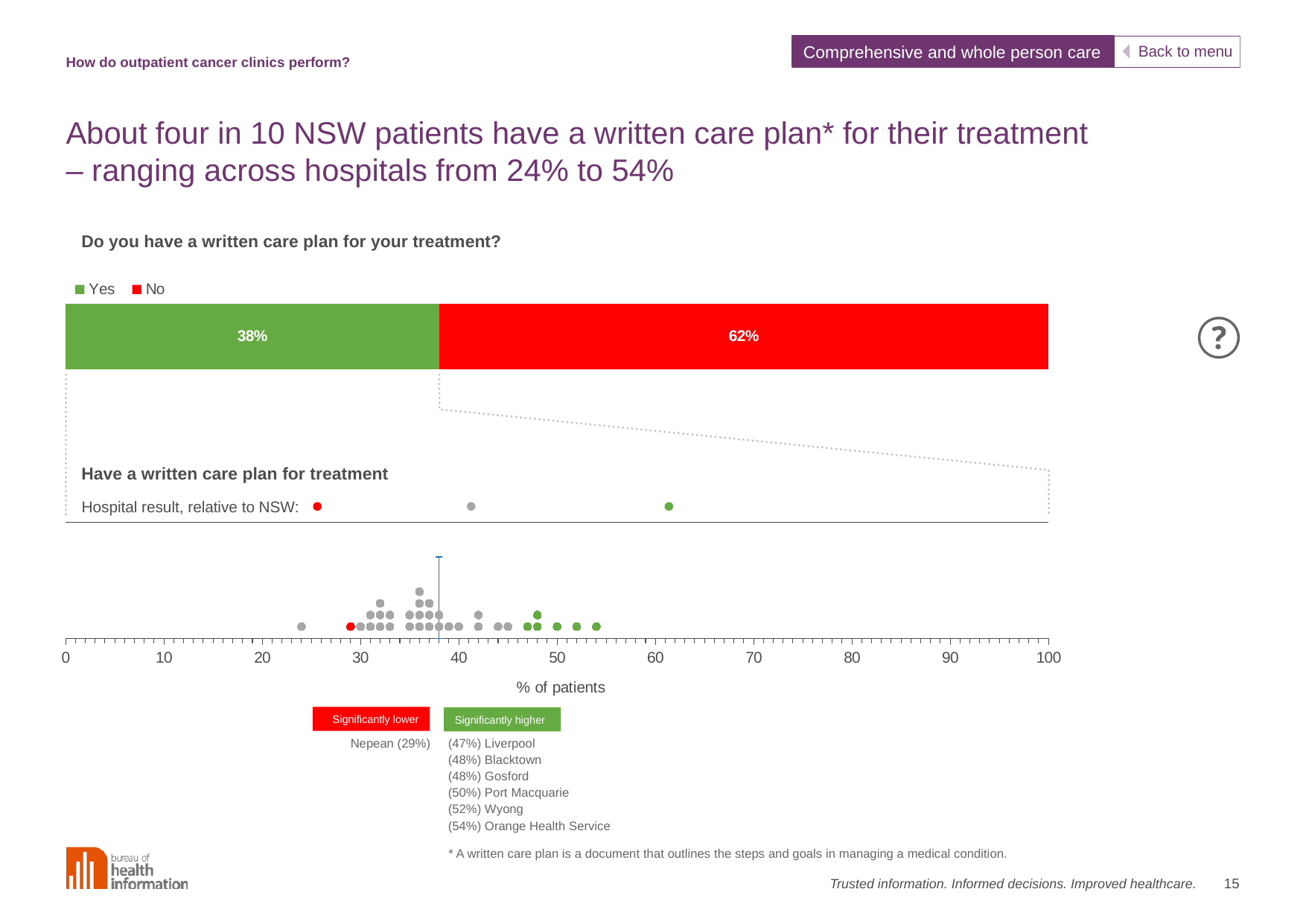
In the dot plot 'Have a written care plan for treatment', how many hospitals are listed as significantly higher? 6 In the dot plot 'Have a written care plan for treatment', what is the result for Wyong? 52% In the stacked bar chart for 'Do you have a written care plan for your treatment?', what percentage of NSW patients answered No? 62% What kind of chart shows the Yes and No responses at the top of the slide? Bar chart In the dot plot 'Have a written care plan for treatment', is the value for Nepean greater or less than 30? less In the dot plot 'Have a written care plan for treatment', what is the result for Orange Health Service? 54% In the stacked bar chart for 'Do you have a written care plan for your treatment?', what percentage of NSW patients answered Yes? 38% In the dot plot 'Have a written care plan for treatment', which of the significantly higher hospitals has the highest result? Orange Health Service In the stacked bar chart, what is the difference between the No and Yes percentages? 24 percentage points In the dot plot 'Have a written care plan for treatment', what is the result for Nepean? 29% How many series does the legend of the stacked bar chart list? 2 In the stacked bar chart, which response is larger, Yes or No? No